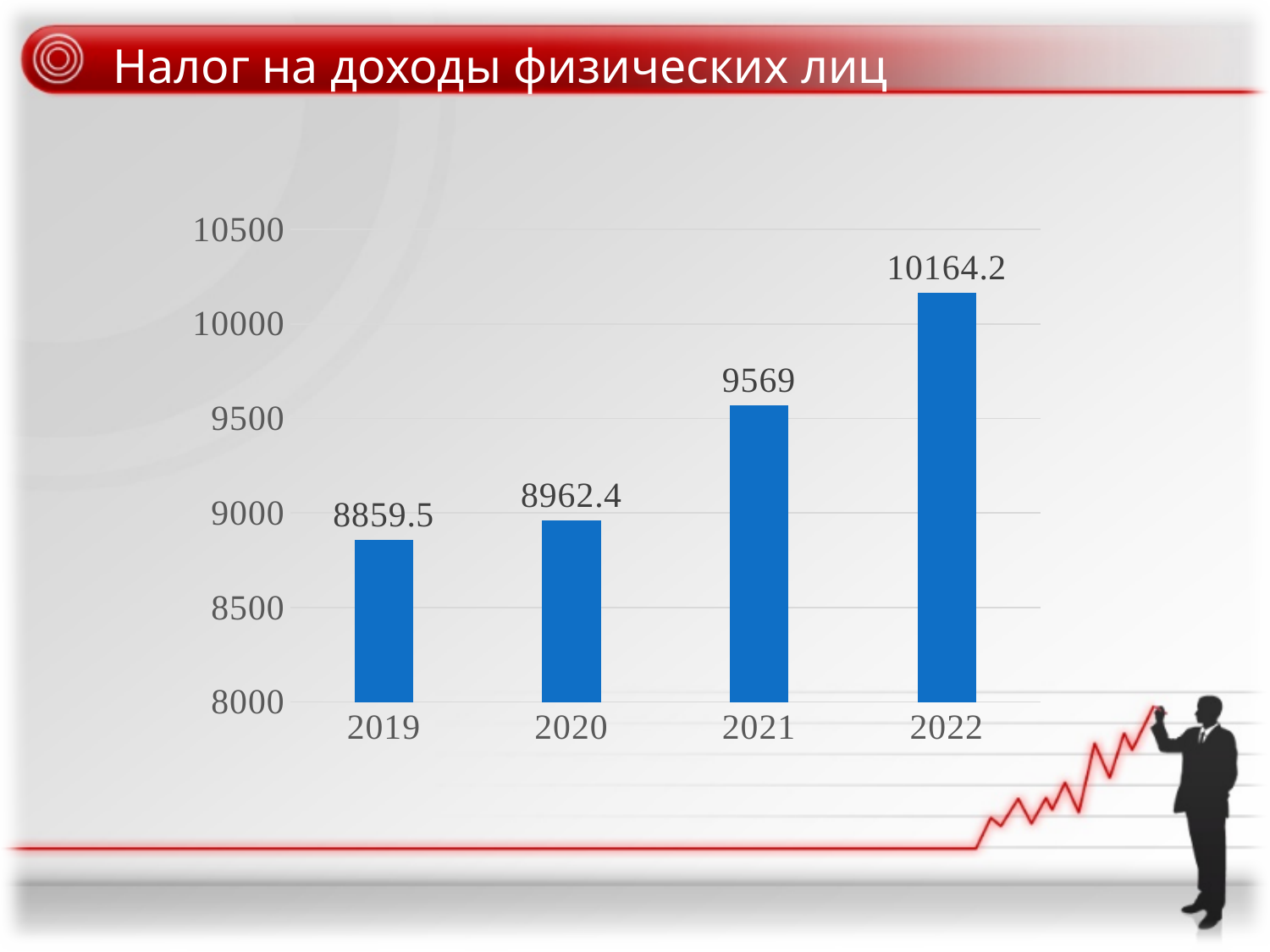
Which year has the highest value? 2022 What is the value for 2022? 10164.2 How many years are shown on the x axis? 4 What kind of chart is shown on the slide? bar chart What is the difference between the values for 2020 and 2019? 102.9 Do the values rise or fall from 2019 to 2022? rise Which year has the lowest value? 2019 What is the value for 2019? 8859.5 Which is larger, the value for 2021 or the value for 2020? 2021 What is the difference between the values for 2022 and 2021? 595.2 What is the value for 2021? 9569 Is the value for 2022 greater or less than 10000? greater